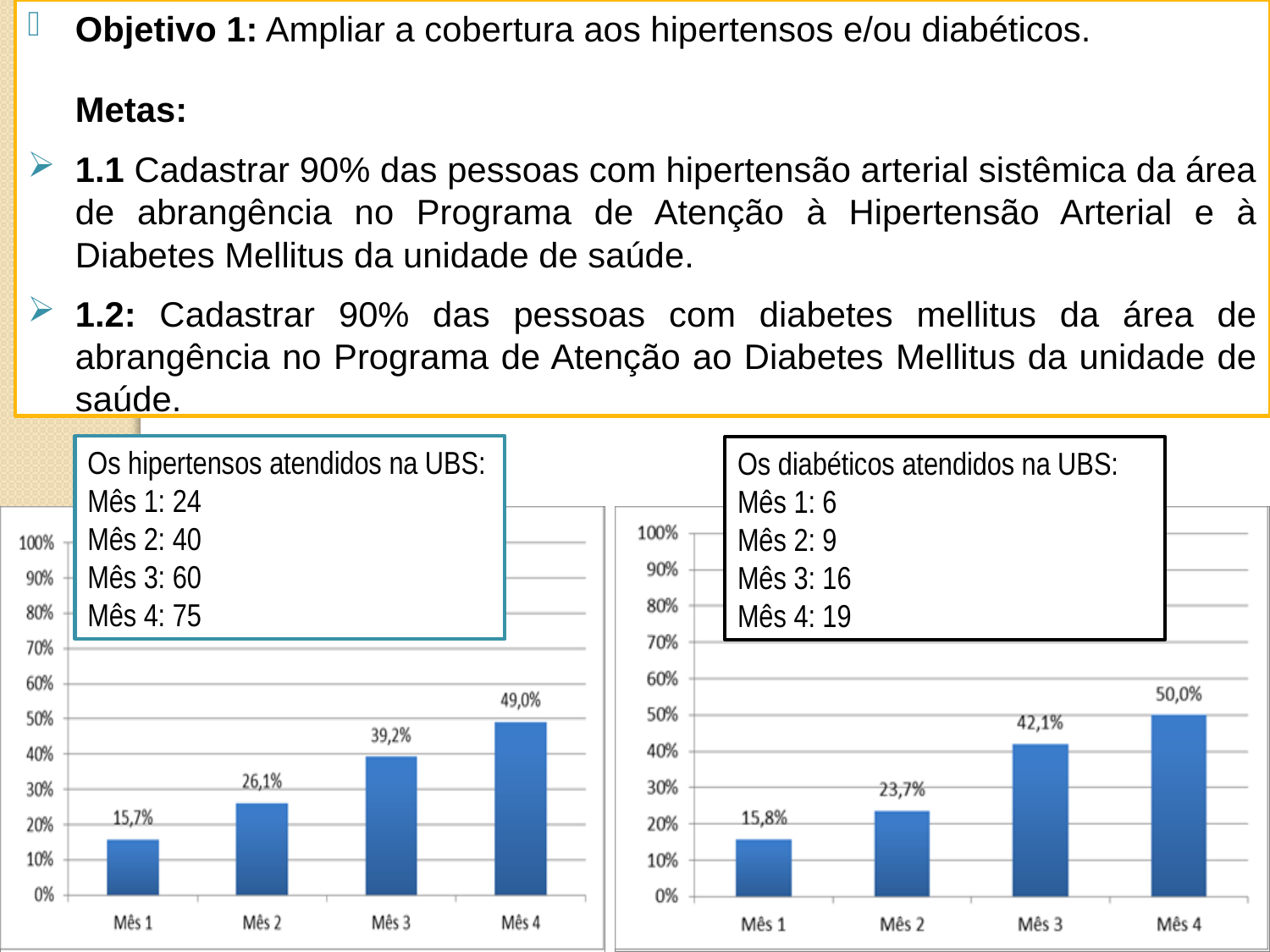
In the right chart, which month has the lowest value? Mês 1 In the left chart, what is the value for Mês 3? 39,2% In the left chart, which month has the highest value? Mês 4 In the right chart, what is the difference between the values for Mês 3 and Mês 2? 18,4% What kind of chart is the right chart? bar chart In the right chart, what is the value for Mês 2? 23,7% In the left chart, what is the value for Mês 4? 49,0% In the right chart, which is larger, the value for Mês 3 or the value for Mês 4? Mês 4 In the left chart, is the value for Mês 2 greater or less than 30%? less How many months are shown on the x axis of the left chart? 4 In the right chart, do the values rise or fall from Mês 1 to Mês 4? rise In the left chart, what is the difference between the values for Mês 4 and Mês 1? 33,3%